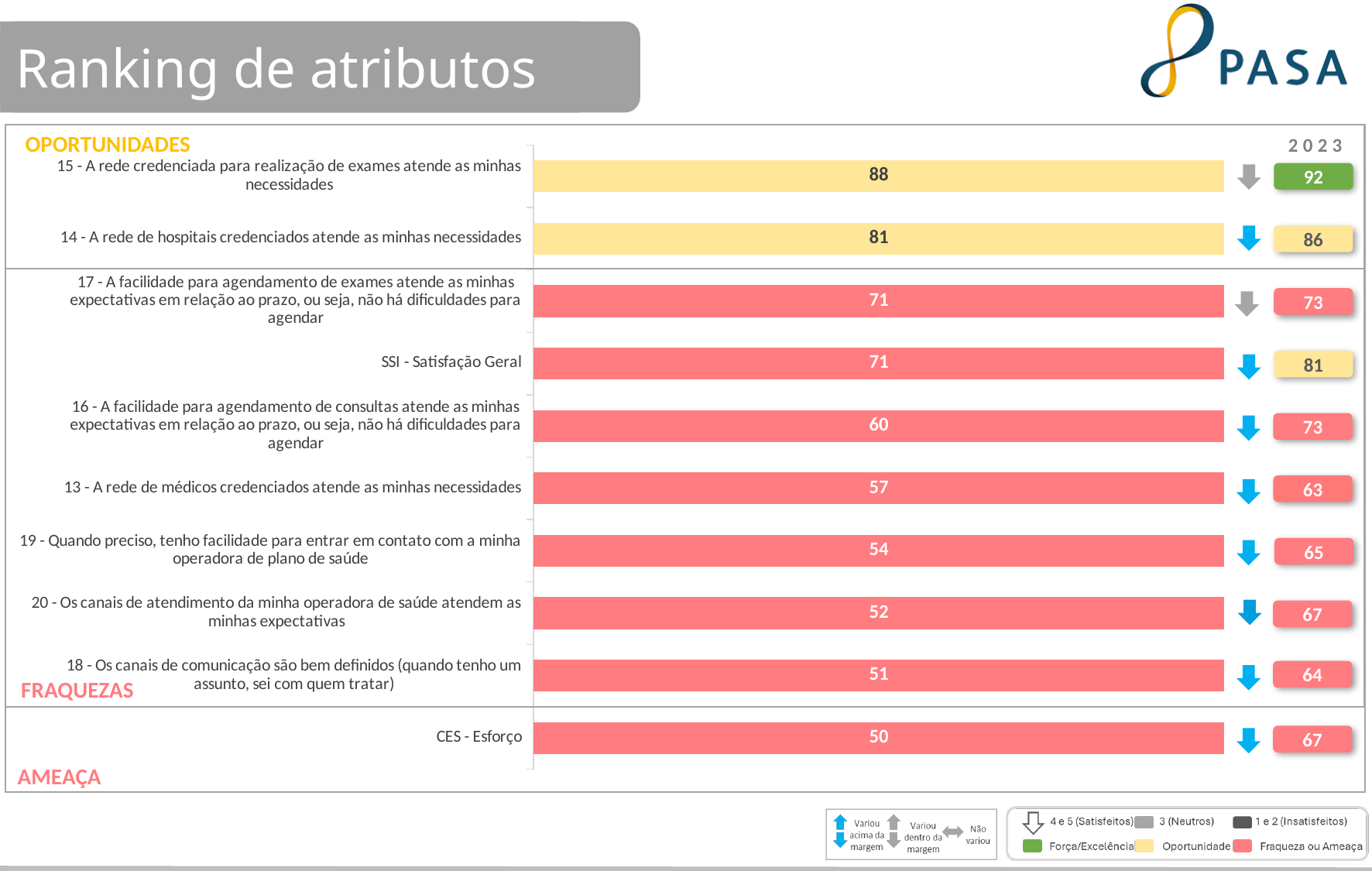
How many bars are plotted in the chart? 10 What kind of chart is shown on the slide? Bar chart What is the difference between the 2023 value (67) and the current value (50) for "CES - Esforço"? 17 What is the difference between the value for attribute 15 (88) and the value for attribute 14 (81)? 7 Which attribute has the highest value in the bar chart? 15 - A rede credenciada para realização de exames atende as minhas necessidades What is the value shown for "SSI - Satisfação Geral"? 71 What was the 2023 value shown for "SSI - Satisfação Geral"? 81 What is the value shown for "14 - A rede de hospitais credenciados atende as minhas necessidades"? 81 Which attribute has the lowest value in the bar chart? CES - Esforço Which attribute is the only one with a green 2023 box (Força/Excelência)? 15 - A rede credenciada para realização de exames atende as minhas necessidades Which has a larger value: "13 - A rede de médicos credenciados atende as minhas necessidades" or "19 - Quando preciso, tenho facilidade para entrar em contato com a minha operadora de plano de saúde"? 13 - A rede de médicos credenciados atende as minhas necessidades What is the value shown for "CES - Esforço"? 50